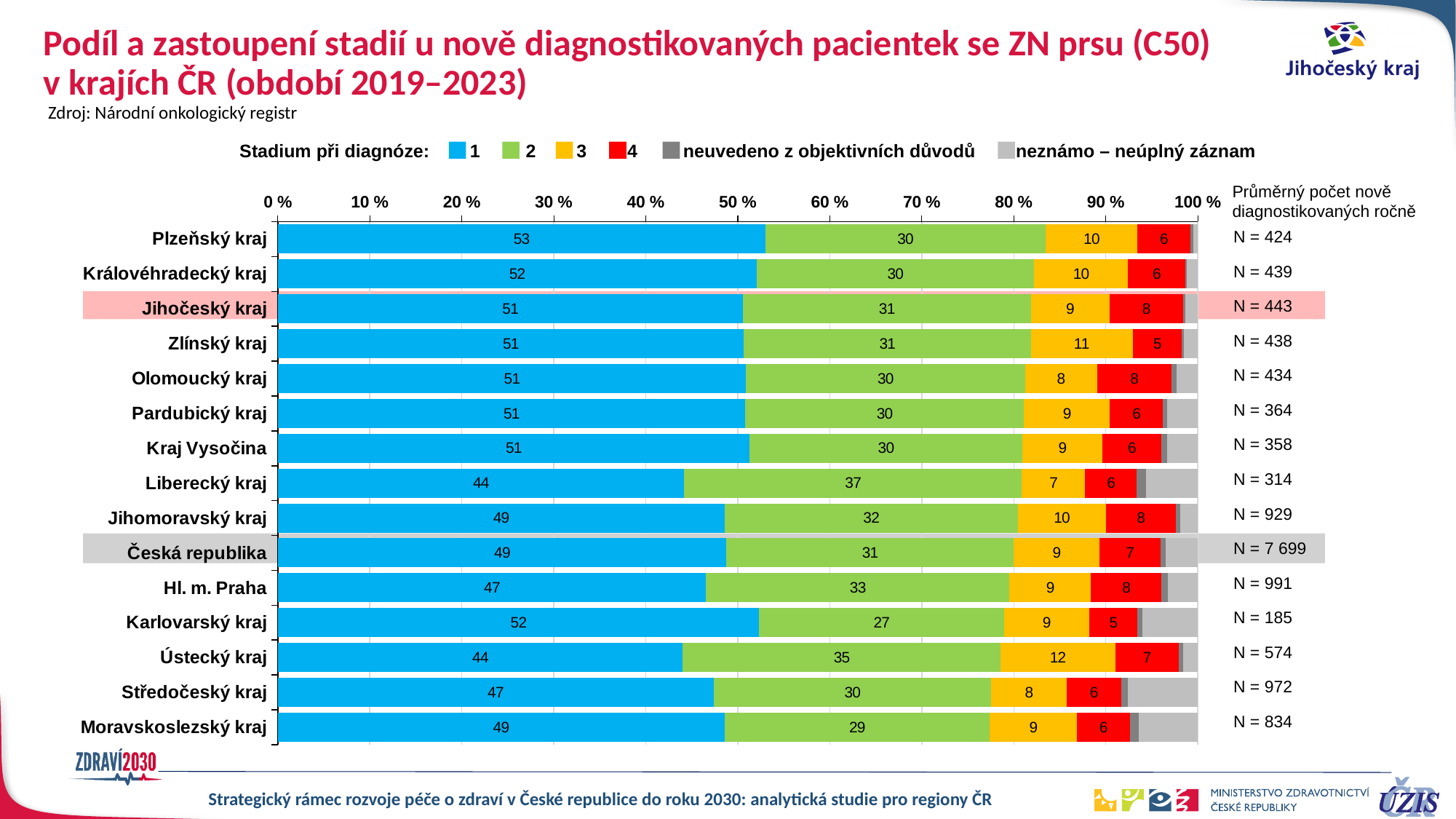
What is the stage 2 share for Liberecký kraj? 37 What is the stage 4 share for Jihočeský kraj? 8 How many regions (rows) are shown in the chart? 15 Which has a larger stage 1 share, Plzeňský kraj or Hl. m. Praha? Plzeňský kraj Which region has the lowest stage 2 share? Karlovarský kraj What is the stage 3 share for Ústecký kraj? 12 Which region has the highest stage 1 share? Plzeňský kraj How many series does the legend list? 6 Which region has the highest stage 3 share? Ústecký kraj What is the difference between the stage 1 share of Plzeňský kraj and that of Ústecký kraj? 9 What kind of chart is shown on the slide? Stacked bar chart What percentage of newly diagnosed patients in Plzeňský kraj were diagnosed at stage 1? 53